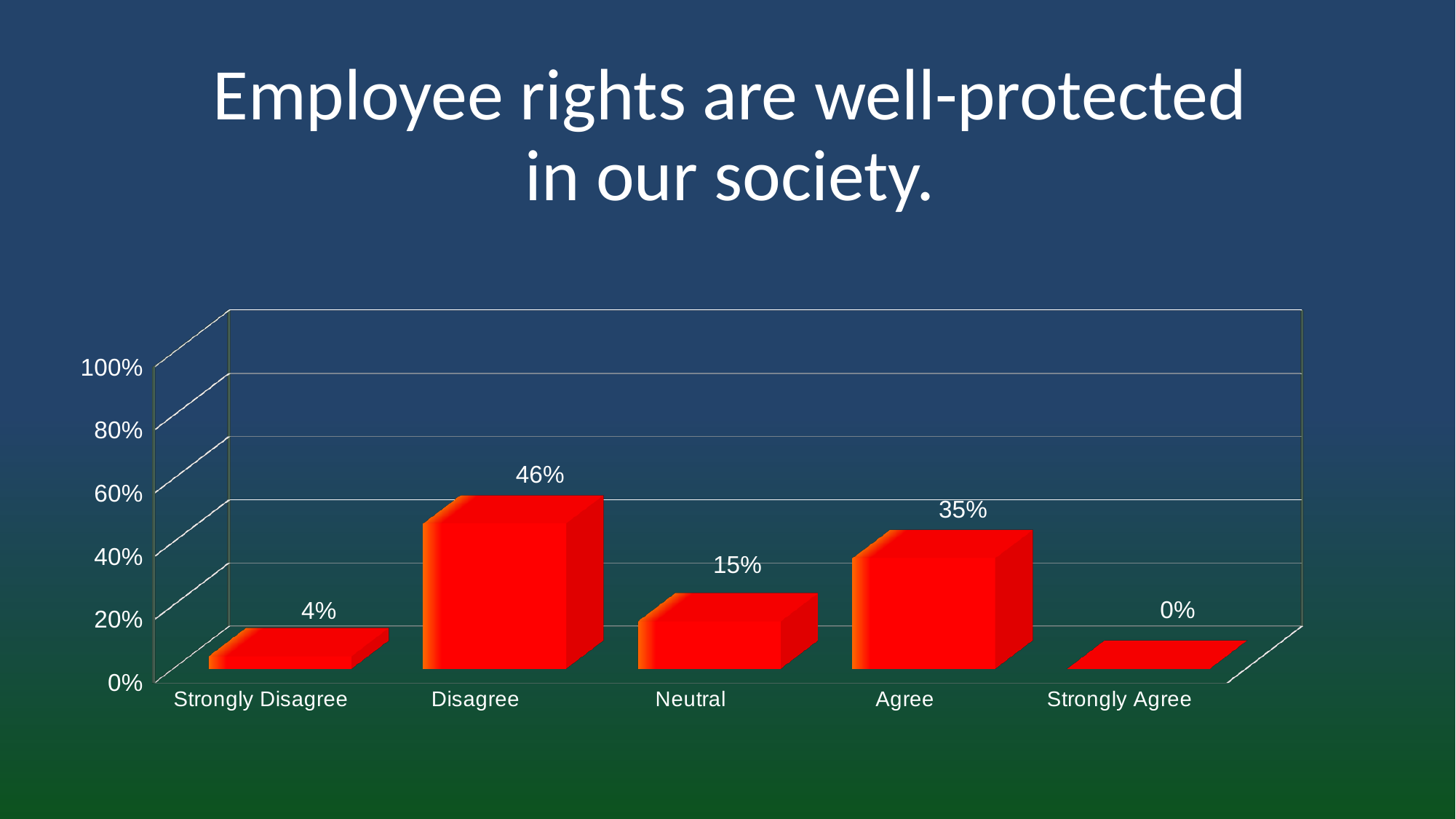
What kind of chart is shown on the slide? bar chart What is the value shown for Agree? 35% What is the value shown for Neutral? 15% What is the difference between the values for Disagree and Agree? 11% What percentage of respondents chose Disagree? 46% How many categories are shown on the x axis? 5 What is the value shown for Strongly Disagree? 4% What is the title of the slide? Employee rights are well-protected in our society. Which is larger, the value for Neutral or the value for Agree? Agree Is the value for Disagree greater or less than 40%? greater Which category has the lowest value? Strongly Agree Which category has the highest value? Disagree